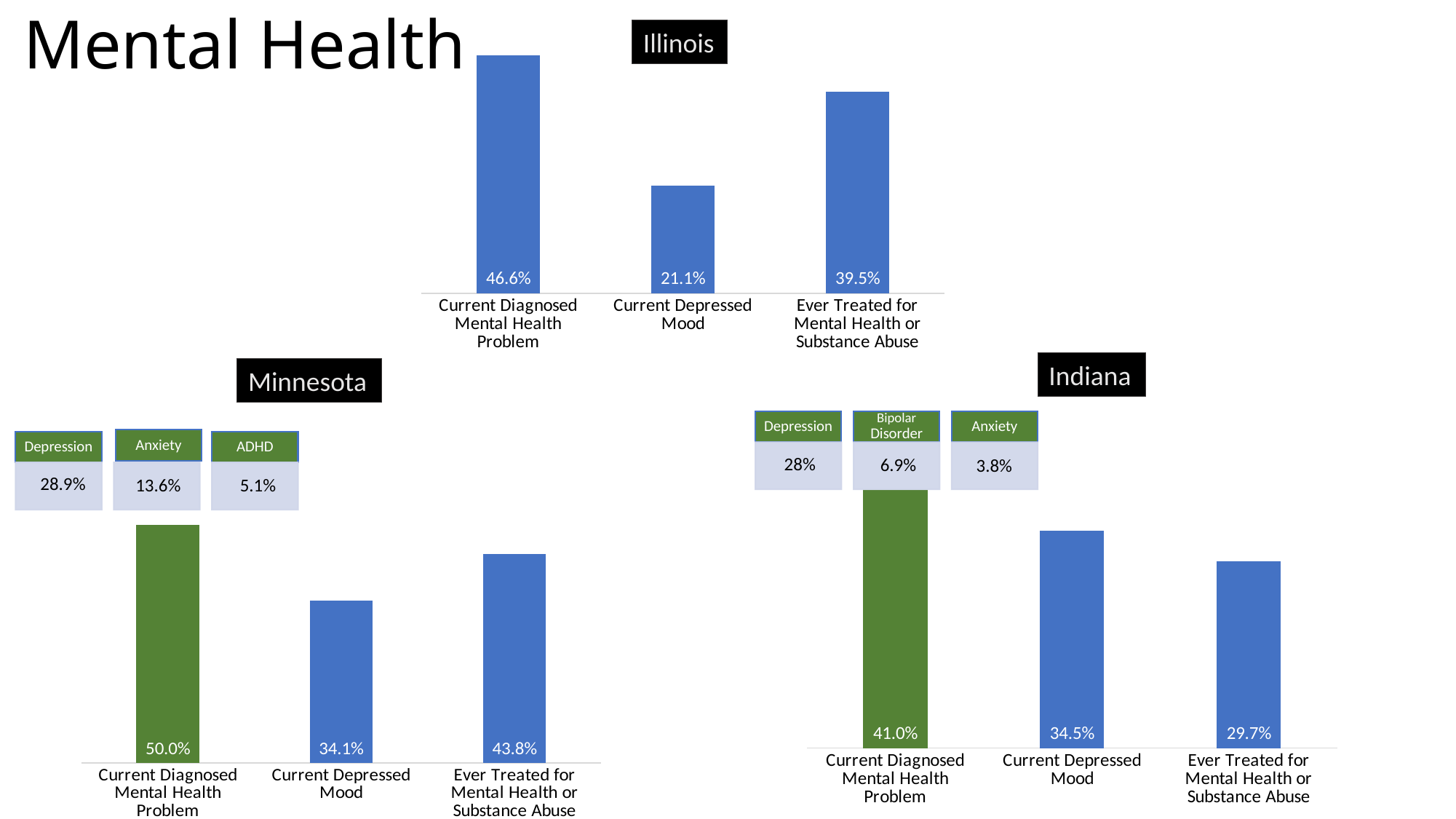
In the Indiana chart, what is the difference between Current Diagnosed Mental Health Problem and Ever Treated for Mental Health or Substance Abuse? 11.3% In the Indiana chart, which category has the lowest value? Ever Treated for Mental Health or Substance Abuse In the Illinois chart, what is the value for Current Diagnosed Mental Health Problem? 46.6% In the Minnesota chart, what colour is the bar for Current Diagnosed Mental Health Problem? Green How many categories are shown in the Indiana chart? 3 In the Illinois chart, what is the difference between Current Diagnosed Mental Health Problem and Current Depressed Mood? 25.5% In the Indiana chart, what is the value for Current Depressed Mood? 34.5% In the Minnesota chart, what is the value for Ever Treated for Mental Health or Substance Abuse? 43.8% In the Minnesota chart, which category has the highest value? Current Diagnosed Mental Health Problem What type of chart is the Illinois chart? Bar chart In the Illinois chart, what is the value for Current Depressed Mood? 21.1% Which is larger: Current Depressed Mood in the Minnesota chart or Current Depressed Mood in the Illinois chart? Minnesota